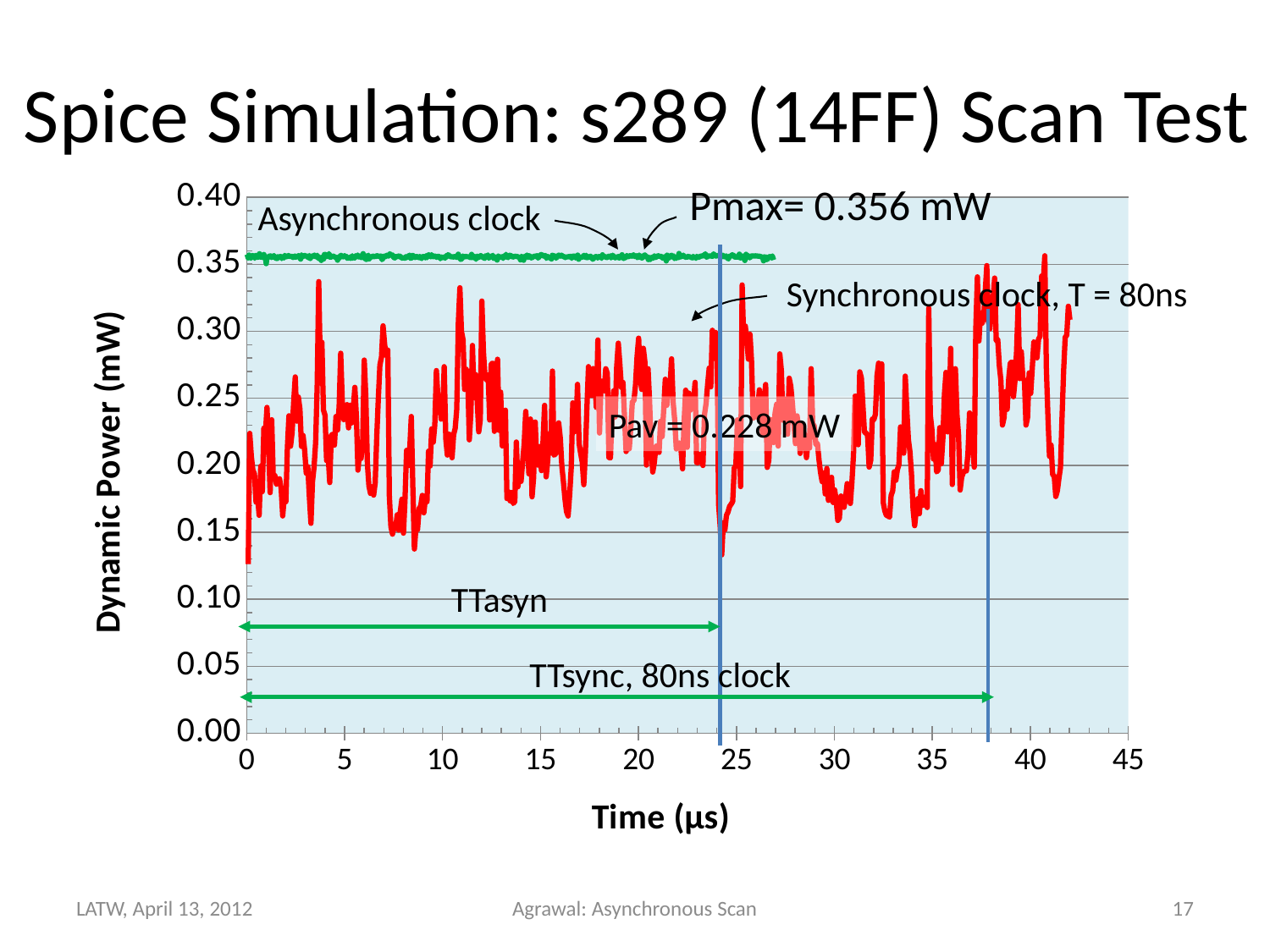
What is the value of Pav shown on the chart? 0.228 mW Is the dynamic power of the synchronous clock at 30 µs greater or less than 0.30 mW? less What clock period is given for the synchronous clock? 80ns What is the label of the x axis? Time (µs) Does the asynchronous clock series rise, fall, or stay roughly constant along the time axis? stays roughly constant What kind of chart is shown on the slide? line chart What is the value of Pmax shown on the chart? 0.356 mW Which series has the higher dynamic power, the asynchronous clock or the synchronous clock? Asynchronous clock Is the dynamic power of the asynchronous clock greater or less than 0.30 mW? greater How many series are plotted on the chart? 2 Which series ends earlier along the time axis, the asynchronous clock or the synchronous clock? Asynchronous clock What is the highest tick value shown on the time axis? 45